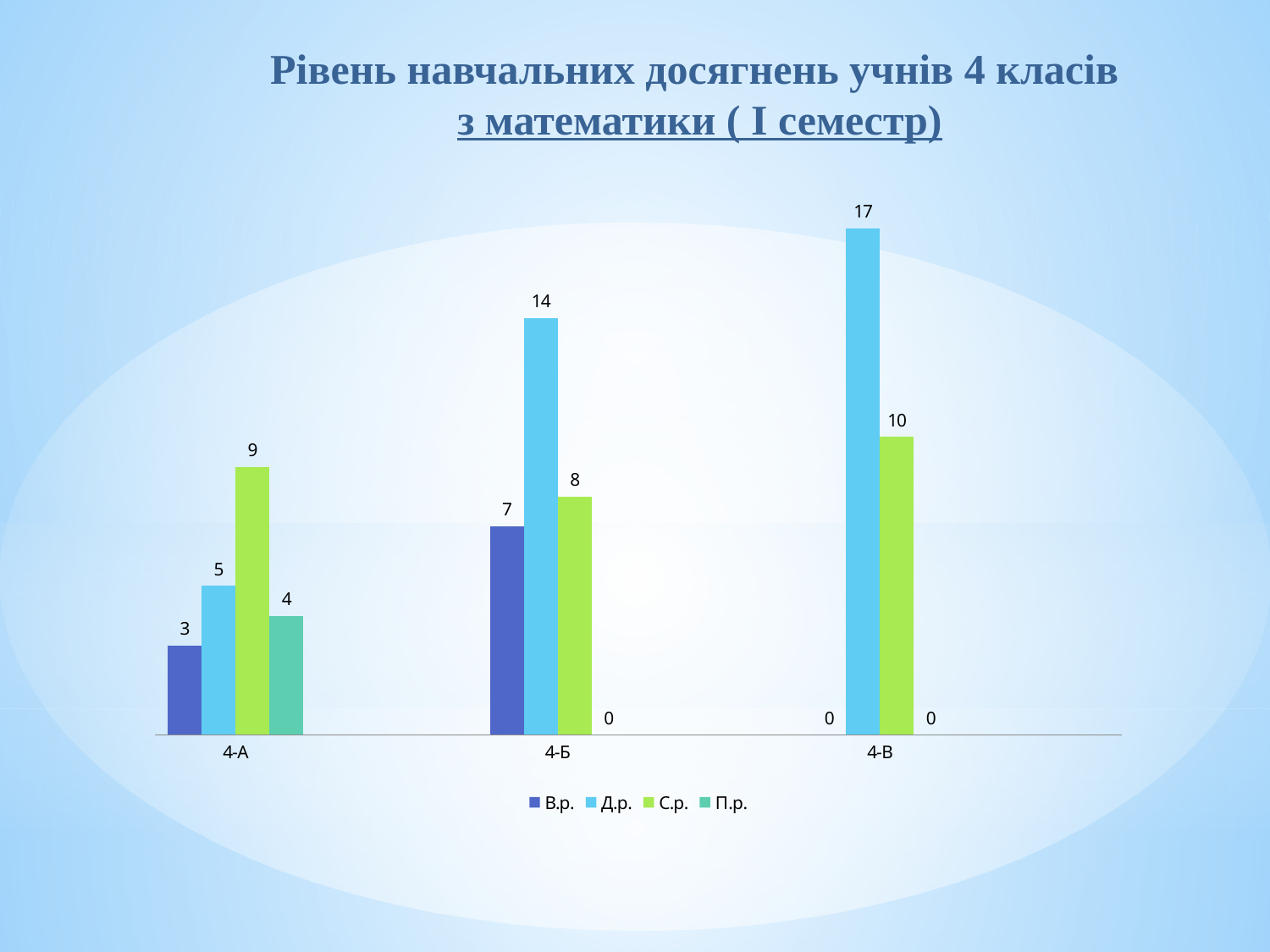
Which is larger: С.р. for 4-А or С.р. for 4-Б? С.р. for 4-А What is the value for С.р. in class 4-А? 9 What is the value for В.р. in class 4-Б? 7 Which class has the lowest value for С.р.? 4-Б Which class has the highest value for Д.р.? 4-В What is the value for П.р. in class 4-В? 0 How many classes are shown on the x axis? 3 What is the value for Д.р. in class 4-В? 17 How many series does the legend list? 4 What kind of chart is shown on the slide? Bar chart What is the difference between the Д.р. values for 4-В and 4-Б? 3 Does the Д.р. value rise or fall from 4-А to 4-В? Rises